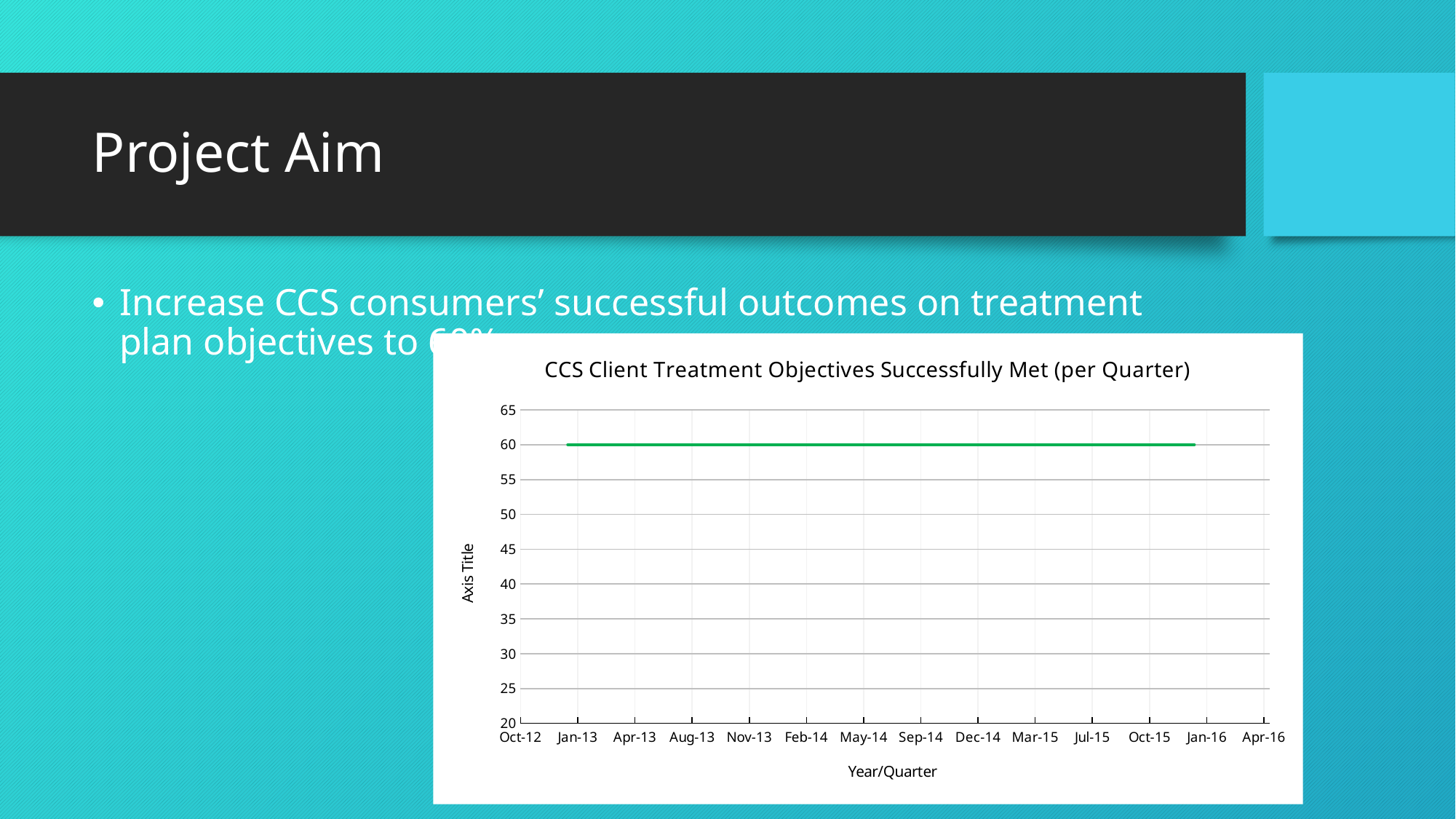
Is the value of the green line at Jul-15 greater or less than 65? less What is the lowest value shown on the y axis of the chart? 20 At what value on the y axis does the green line sit? 60 What kind of chart is shown on the slide? line chart What is the label on the x axis of the chart? Year/Quarter Is the value of the green line at Apr-13 greater or less than 40? greater What is the title of the chart? CCS Client Treatment Objectives Successfully Met (per Quarter) How many tick labels are shown along the x axis of the chart? 14 Does the plotted line rise, fall, or stay flat across the x axis? stay flat